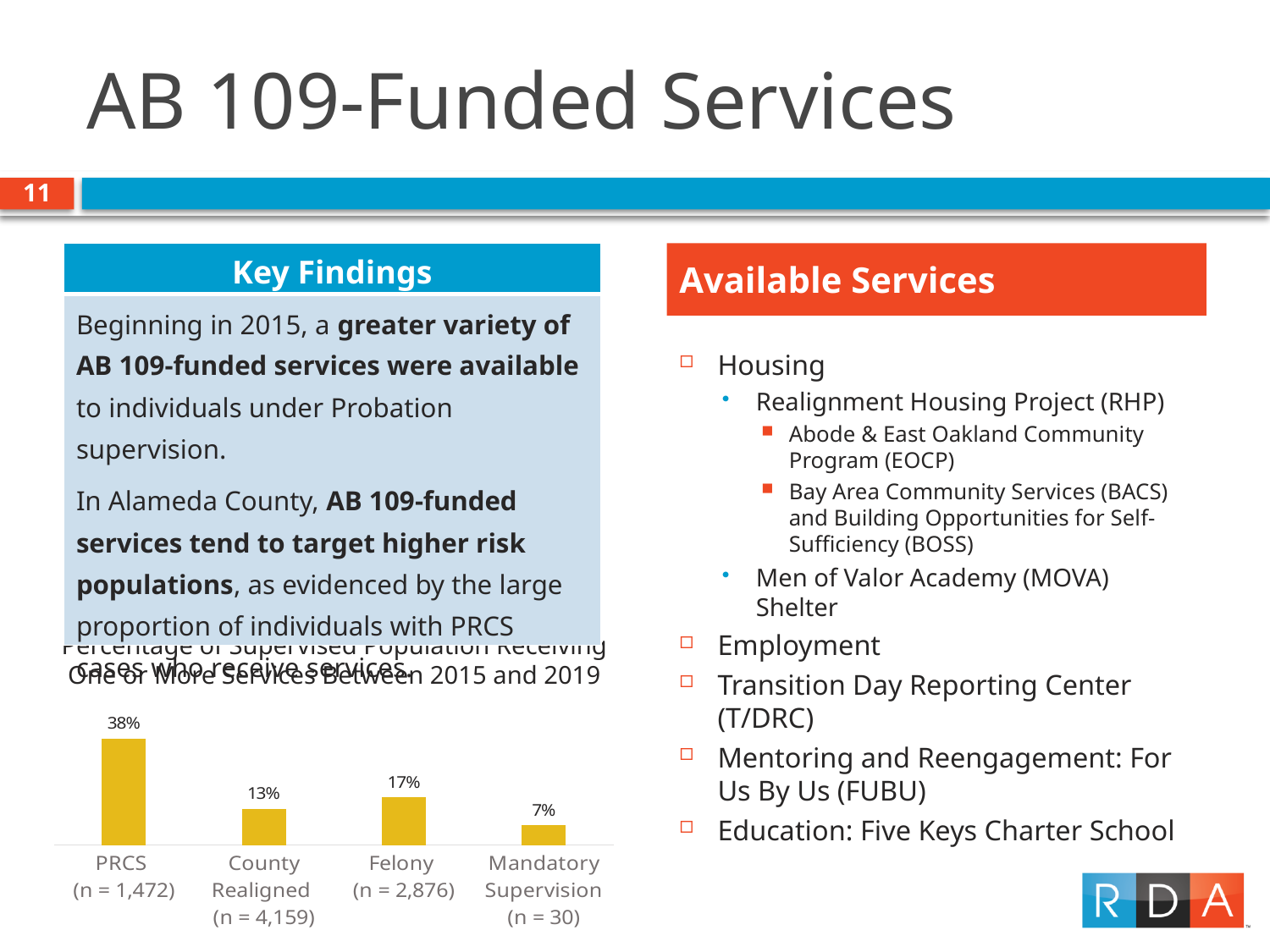
How many categories are shown in the bar chart? 4 What percentage is shown for PRCS in the bar chart? 38% What percentage is shown for County Realigned in the bar chart? 13% What is the difference in percentage points between PRCS and Felony in the bar chart? 21 What sample size (n) is shown for the Mandatory Supervision category in the bar chart? n = 30 Which has a higher percentage in the bar chart, County Realigned or Felony? Felony Which category has the lowest percentage in the bar chart? Mandatory Supervision What type of chart is shown on the slide? Bar chart Which category has the highest percentage in the bar chart? PRCS What percentage is shown for Mandatory Supervision in the bar chart? 7% What percentage is shown for Felony in the bar chart? 17% What is the difference in percentage points between Felony and County Realigned in the bar chart? 4